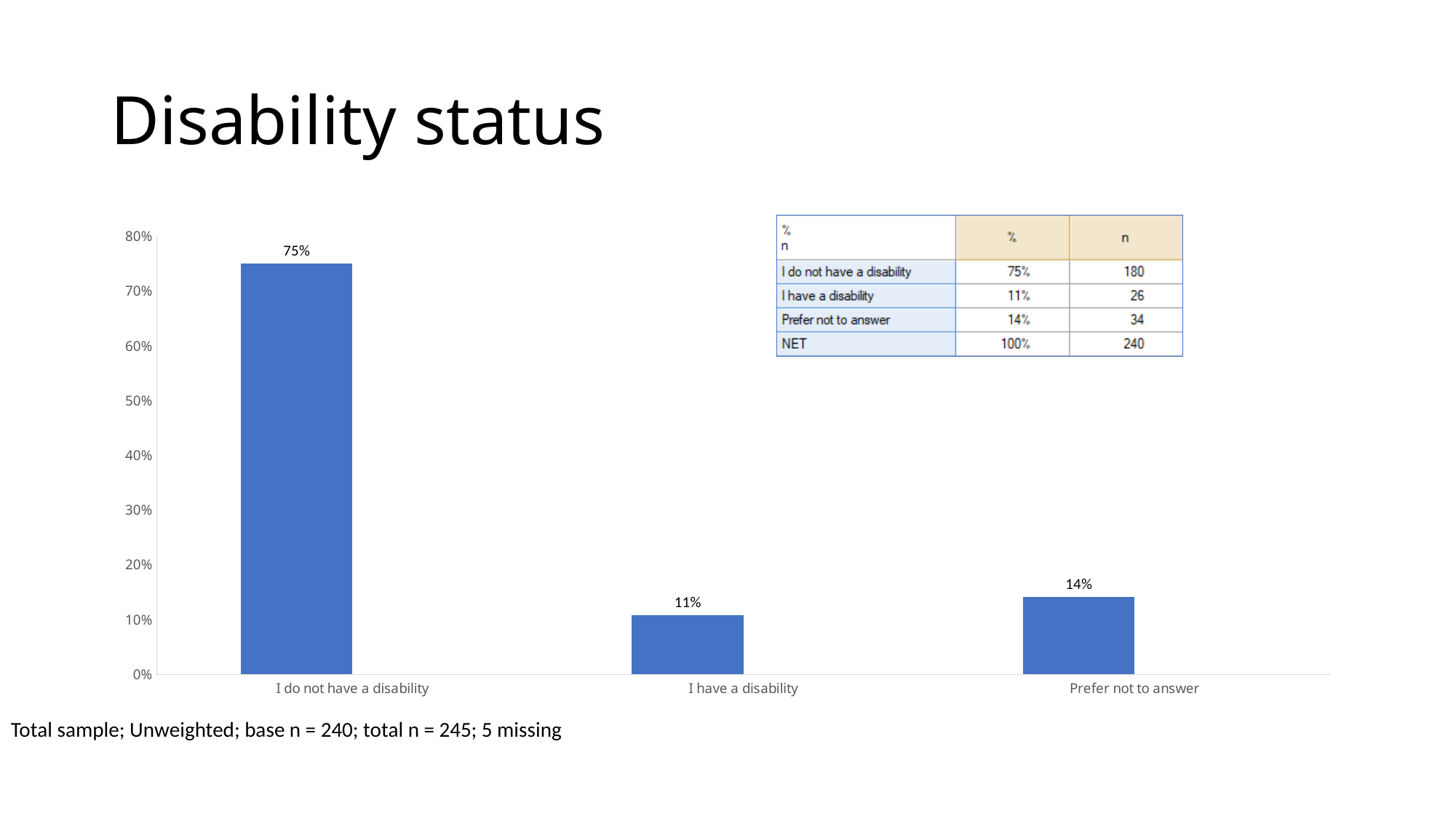
What is the difference between the values for 'I do not have a disability' and 'Prefer not to answer'? 61% Which category has the highest value? I do not have a disability Is the value for 'I do not have a disability' greater or less than 70%? greater What is the value for 'Prefer not to answer'? 14% What is the value for 'I do not have a disability'? 75% What is the value for 'I have a disability'? 11% Which is larger, the value for 'I have a disability' or the value for 'Prefer not to answer'? Prefer not to answer What is the difference between the values for 'Prefer not to answer' and 'I have a disability'? 3% What is the title of the slide containing the chart? Disability status How many categories are shown on the x axis of the chart? 3 What kind of chart is shown on the slide? bar chart Which category has the lowest value? I have a disability